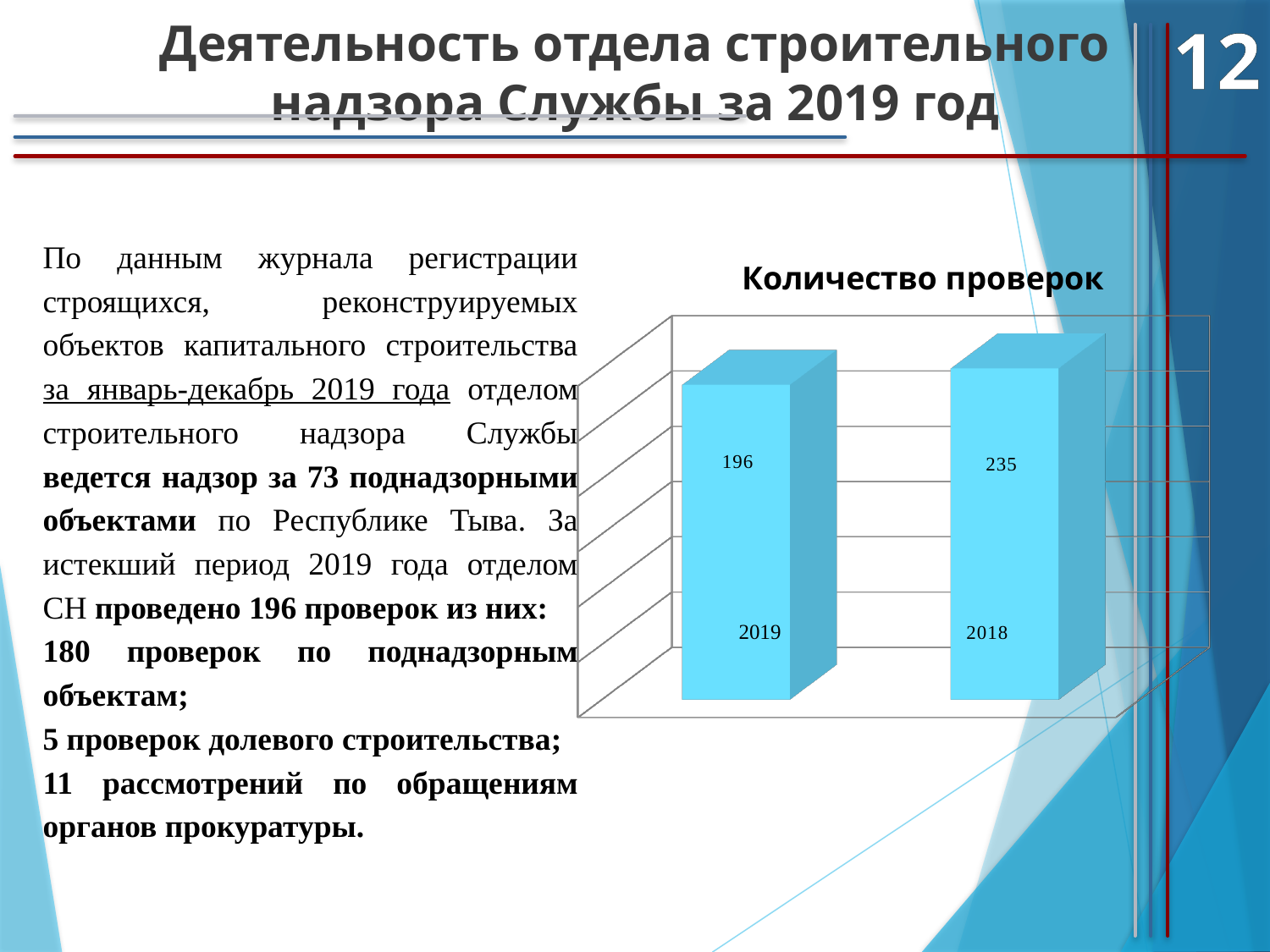
What is the difference between the values for 2018 and 2019? 39 Which year has the lowest value in the chart? 2019 Which years are shown as categories in the chart? 2019 and 2018 How many bars does the chart show? 2 Which year has the highest value in the chart? 2018 What is the value for 2018 in the chart? 235 What is the value for 2019 in the chart? 196 What is the title of the chart? Количество проверок Does the value rise or fall from the left bar (2019) to the right bar (2018)? rise Which is larger, the value for 2019 or the value for 2018? 2018 What type of chart is shown on the slide? bar chart